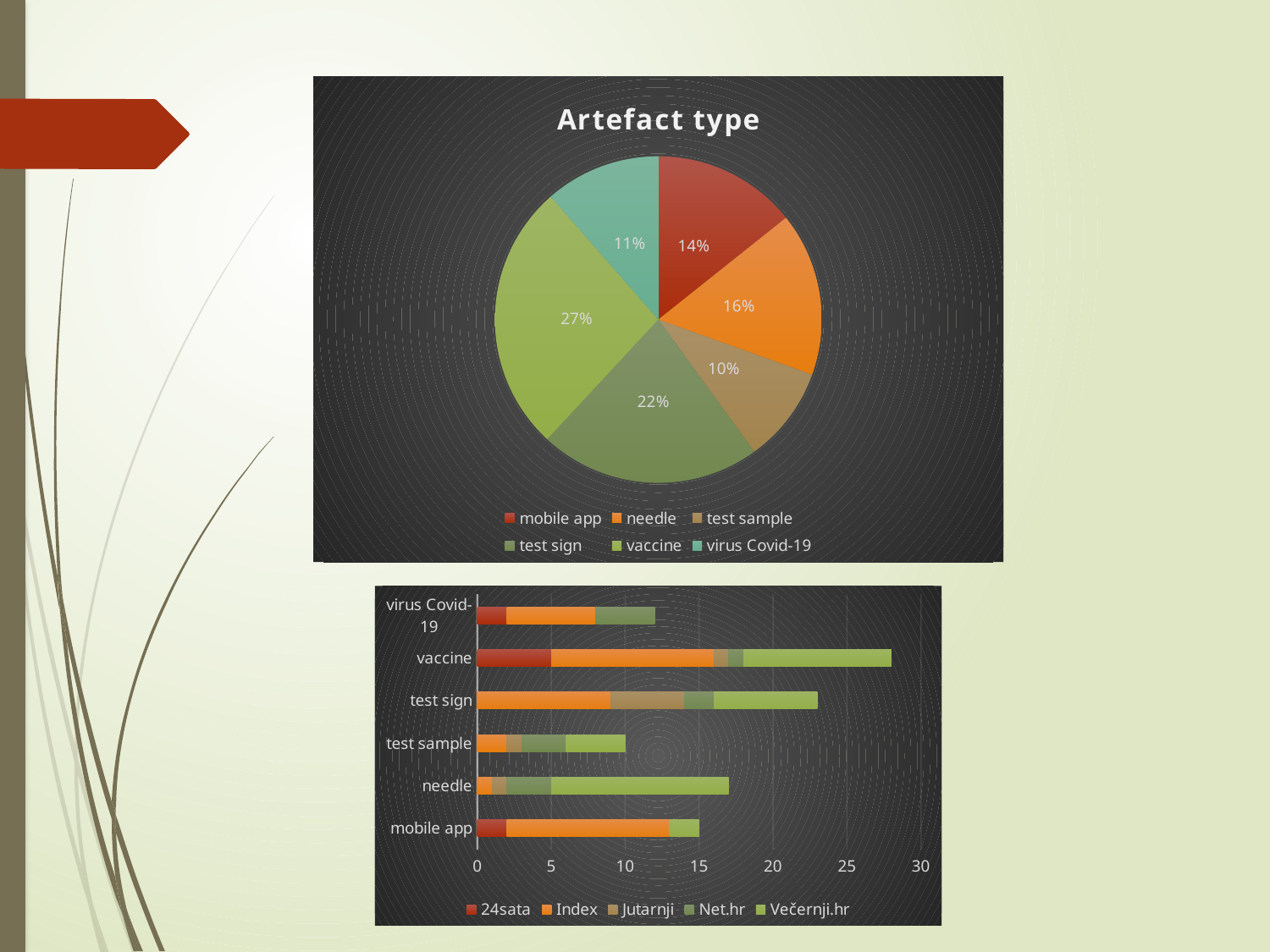
In the lower bar chart, how many series does the legend list? 5 In the pie chart titled "Artefact type", what percentage is shown for needle? 16% In the pie chart titled "Artefact type", which artefact type has the largest share? vaccine In the pie chart titled "Artefact type", how many slices are there? 6 In the pie chart titled "Artefact type", what percentage is shown for test sample? 10% In the lower bar chart, is the total bar length for vaccine greater or less than 25? greater In the pie chart titled "Artefact type", what is the difference in percentage points between test sign and mobile app? 8 In the lower bar chart, which category has the longest total bar? vaccine In the pie chart titled "Artefact type", which artefact type has the smallest share? test sample What kind of chart is the lower chart on the slide? Stacked bar chart In the lower bar chart, is the total bar length for test sample greater or less than 15? less In the pie chart titled "Artefact type", what percentage is shown for vaccine? 27%